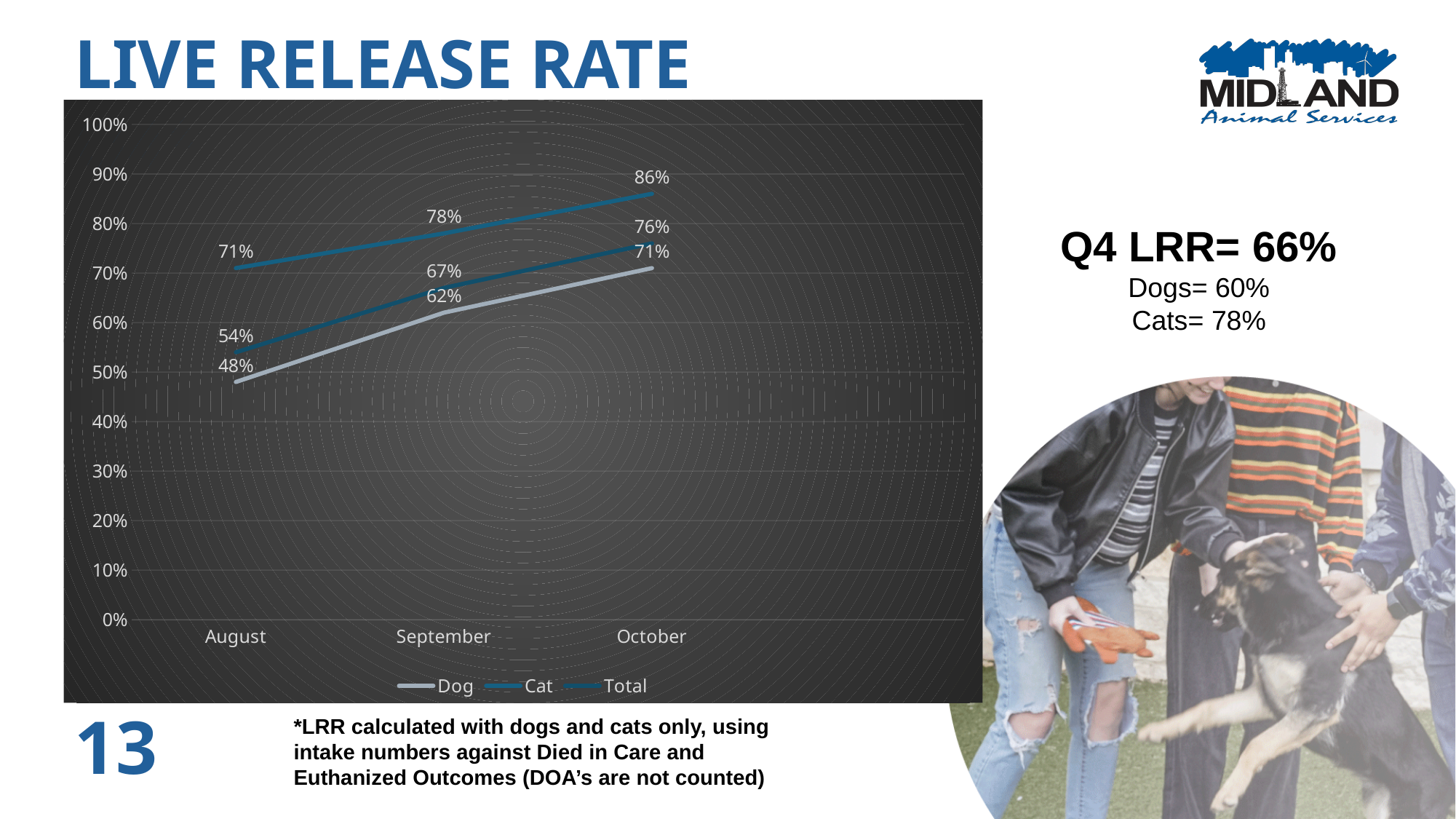
How many series does the chart legend list? 3 Which month has the highest Cat live release rate? October Which month has the lowest Dog live release rate? August What is the difference between the Cat and Dog live release rates in August? 23% Do the Dog live release rates rise or fall from August to October? rise What is the Total live release rate in September? 67% How many months are shown on the x axis of the chart? 3 What is the live release rate for Dog in August? 48% What kind of chart is shown on the slide? line chart What is the live release rate for Cat in October? 86% What is the title of the slide containing the chart? LIVE RELEASE RATE Which is larger in September, the Cat rate or the Total rate? Cat